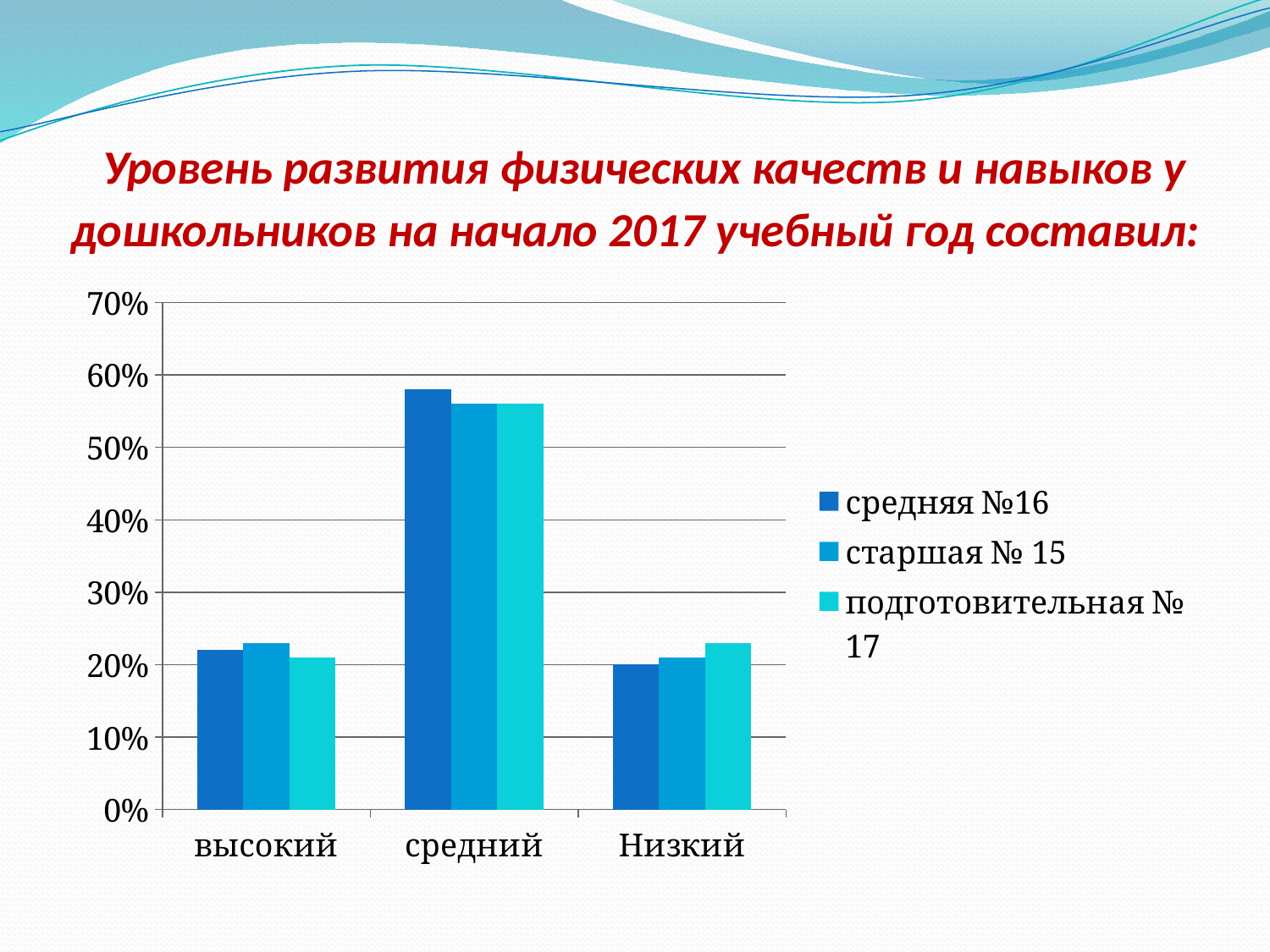
For the series старшая № 15, which is larger: the value for средний or the value for Низкий? средний How many categories are shown on the x axis of the chart? 3 Which category has the highest value for the series средняя №16? средний What is the highest value shown on the chart's y axis? 70% Which category has the highest value for the series подготовительная № 17? средний Is the value for средний in the series старшая № 15 greater or less than 60%? less What kind of chart is shown on the slide? bar chart What is the name of the third series listed in the legend? подготовительная № 17 Is the value for высокий in the series старшая № 15 greater or less than 30%? less How many series does the chart's legend list? 3 Is the value for средний in the series средняя №16 greater or less than 50%? greater